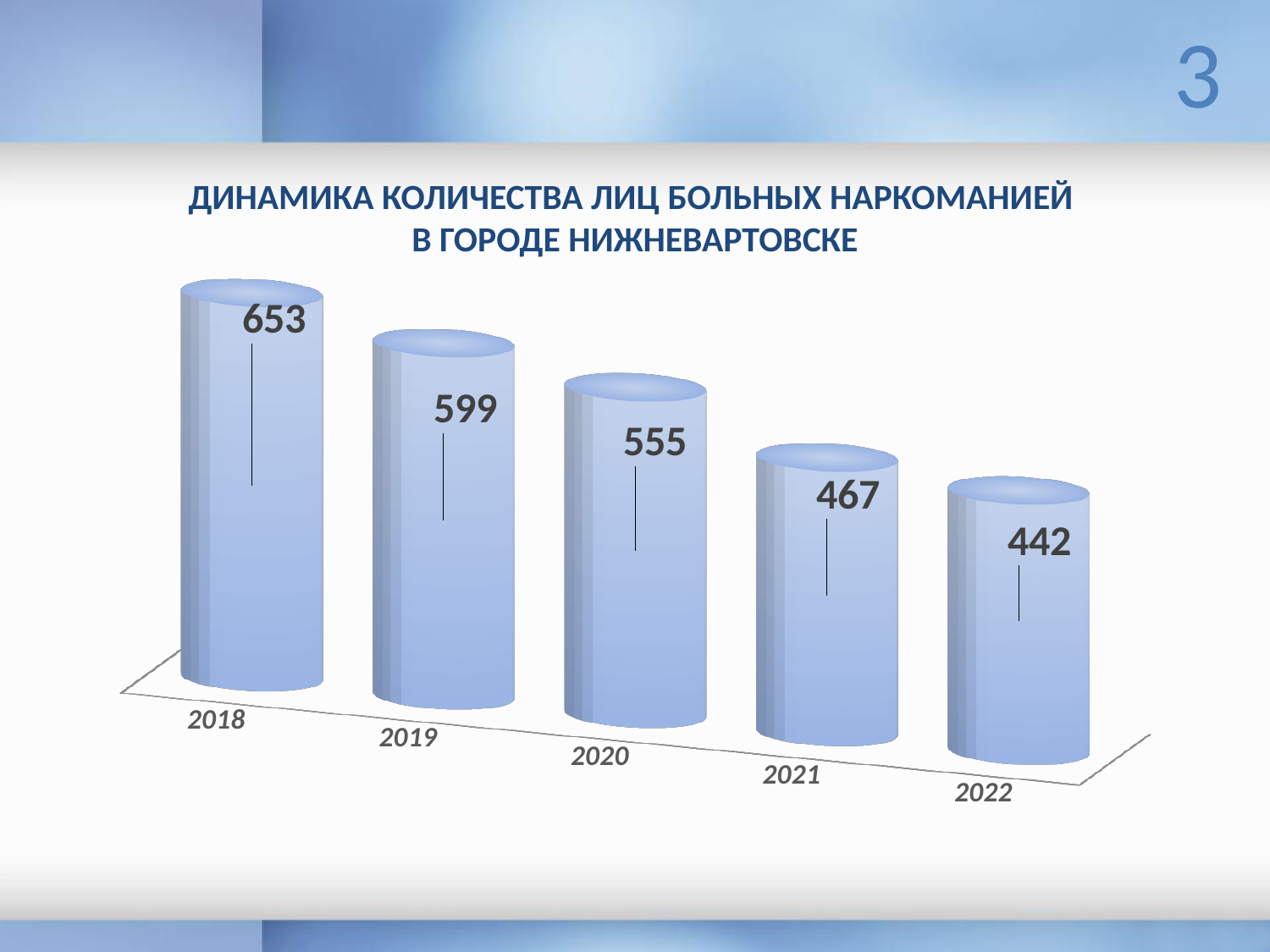
What is the difference between the values for 2019 and 2020? 44 Which year has the lowest value? 2022 Which year has the highest value? 2018 What kind of chart is shown on the slide? bar chart What is the title of the chart? ДИНАМИКА КОЛИЧЕСТВА ЛИЦ БОЛЬНЫХ НАРКОМАНИЕЙ В ГОРОДЕ НИЖНЕВАРТОВСКЕ What is the value for 2018? 653 What is the difference between the values for 2018 and 2022? 211 What is the value for 2022? 442 What is the value for 2020? 555 Which is larger, the value for 2021 or the value for 2022? 2021 How many years are shown on the chart? 5 Do the values rise or fall from 2018 to 2022? fall